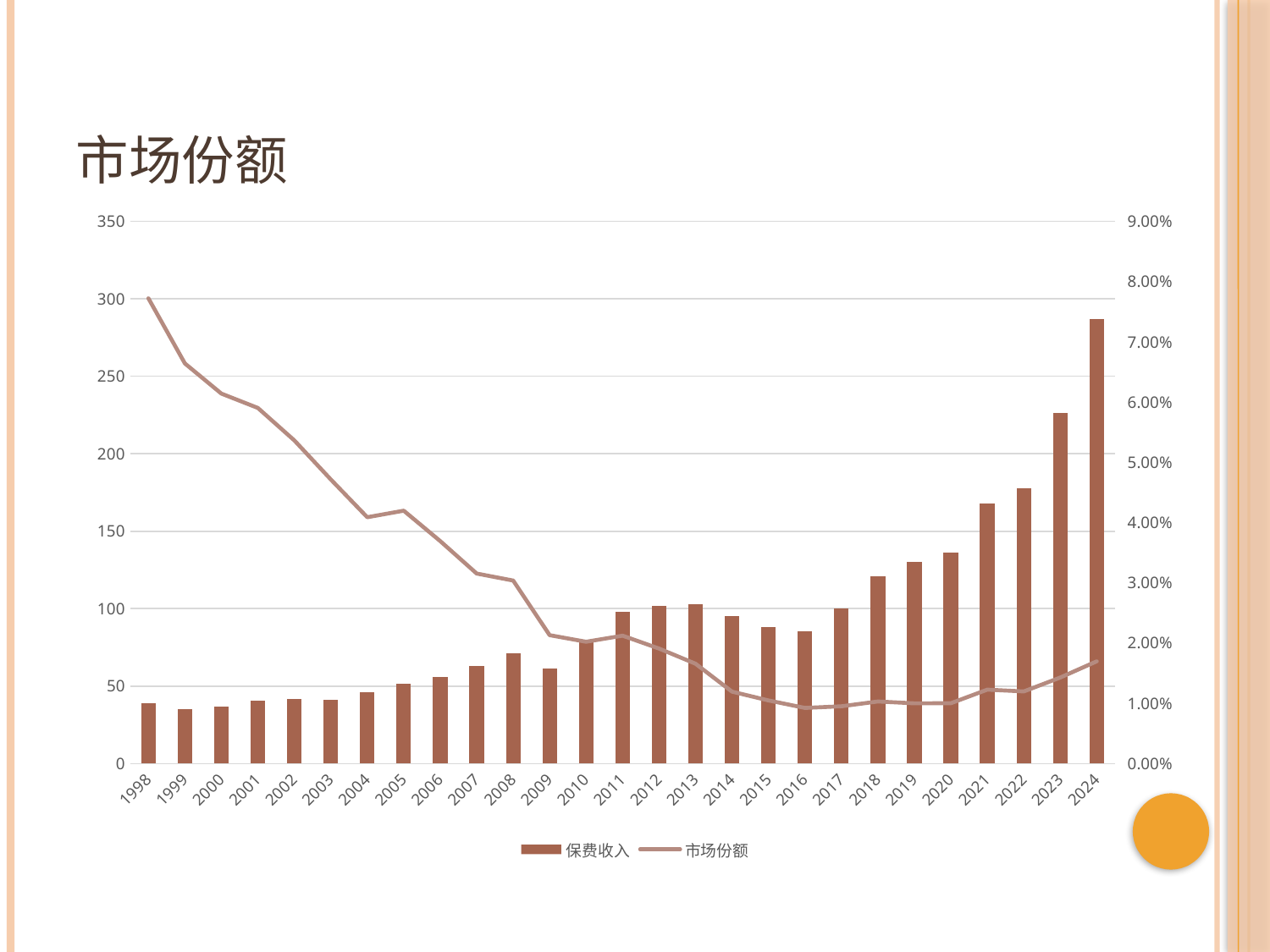
Is the 市场份额 value for 1998 greater or less than 7.00%? greater What kind of chart is this? Combined bar and line chart Which is larger, the 保费收入 bar for 2013 or for 2016? 2013 How many series does the legend list? 2 How many years are shown on the x axis? 27 Is the 市场份额 value for 2014 greater or less than 2.00%? less Is the 保费收入 value for 2024 greater or less than 250? greater Which year has the highest 保费收入 bar? 2024 What is the title of the chart? 市场份额 Does the 市场份额 line generally rise or fall from 1998 to 2016? fall In which year is the 市场份额 line at its highest? 1998